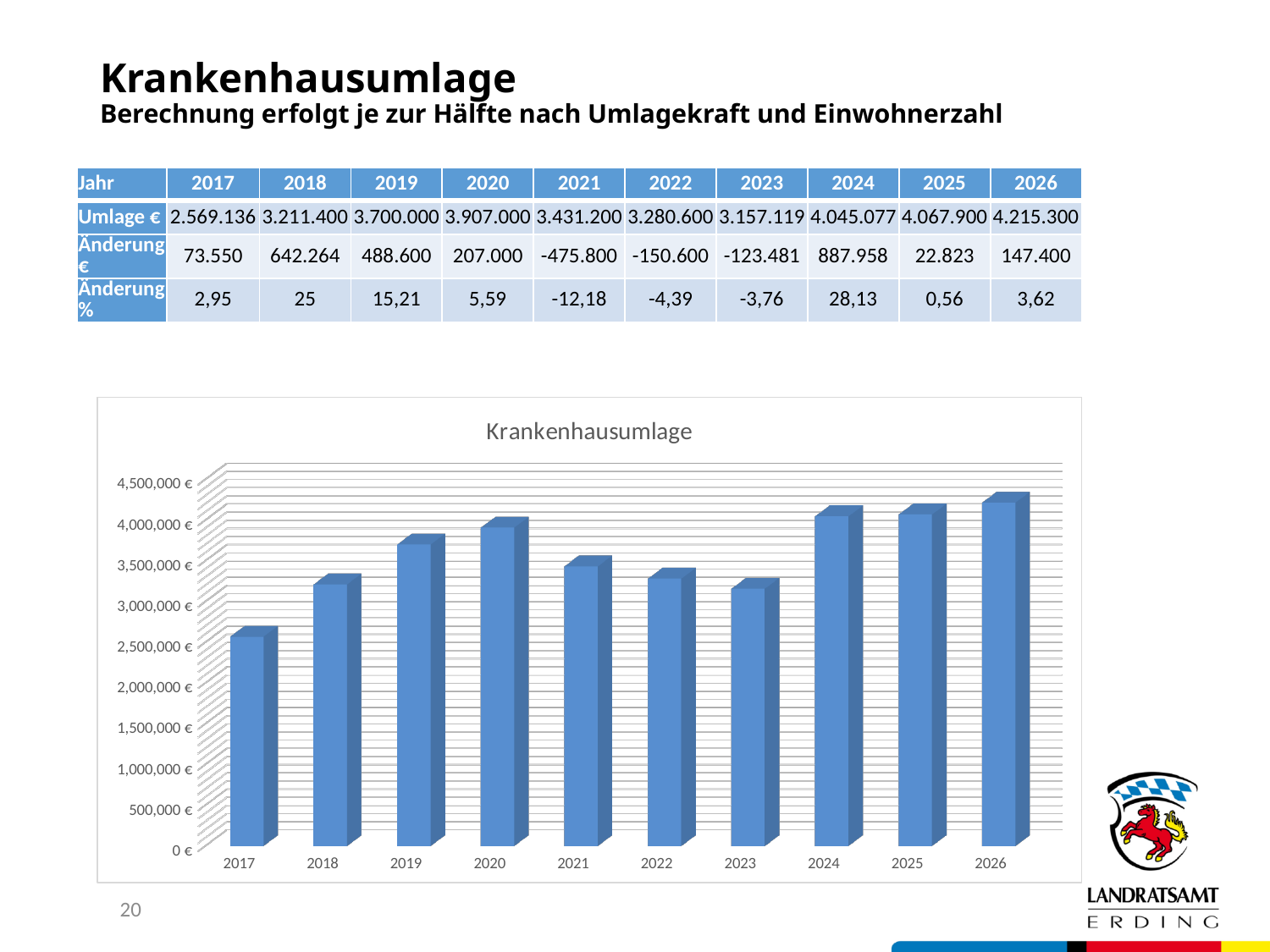
What is the title of the chart? Krankenhausumlage How many years are plotted on the x axis of the chart? 10 Do the values rise or fall from 2020 to 2023? fall Is the value for 2020 greater or less than 4,000,000 €? less According to the table on the slide, what is the Umlage € for 2026? 4.215.300 Is the value for 2017 greater or less than 2,500,000 €? greater Is the value for 2021 greater or less than 3,500,000 €? less Which year has the lowest Krankenhausumlage in the chart? 2017 What kind of chart is shown on the slide? bar chart Which year has the highest Krankenhausumlage in the chart? 2026 Which is larger, the value for 2019 or the value for 2021? 2019